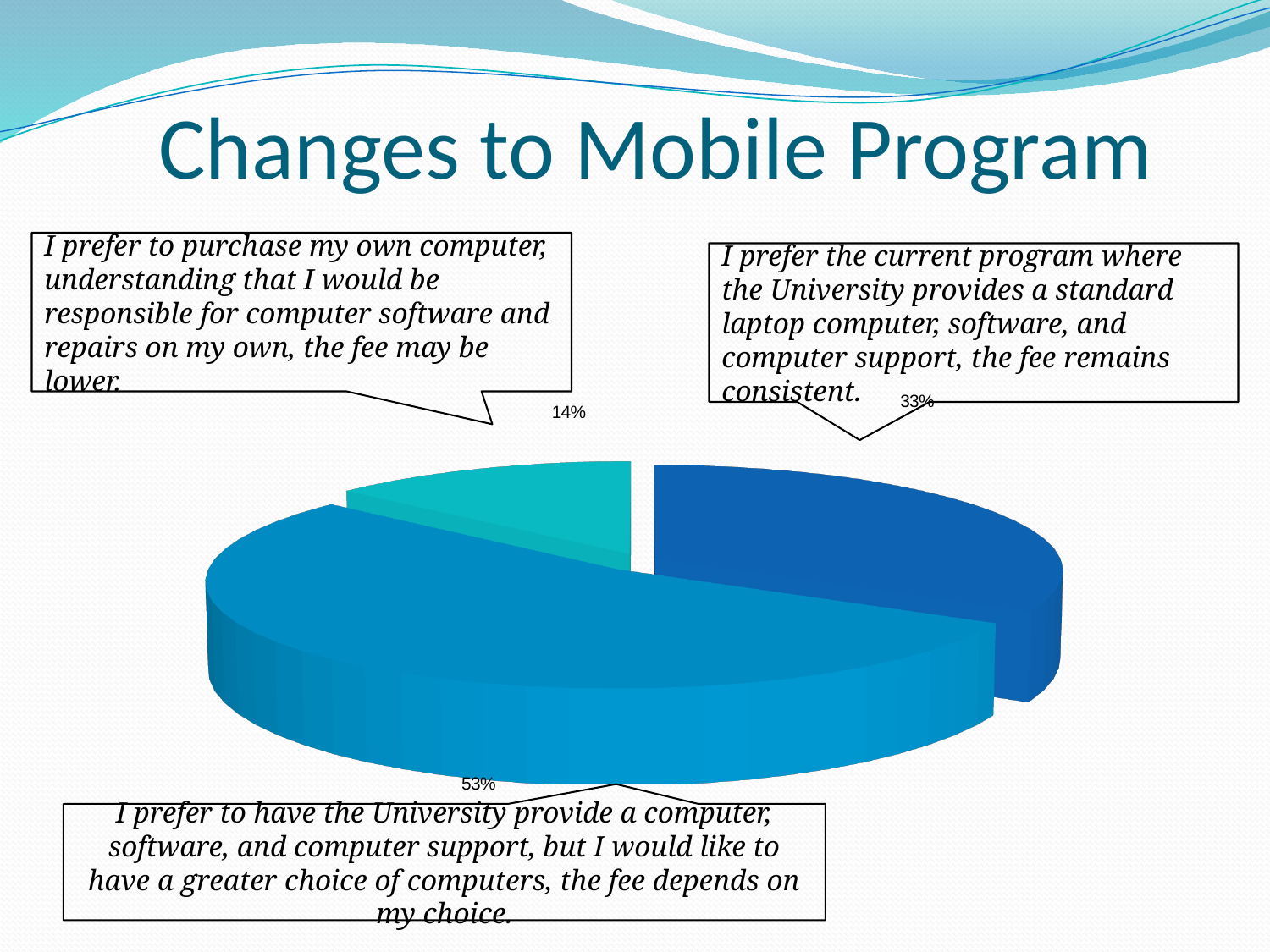
What colour is the slice representing 14%? teal What is the difference in percentage points between the 'greater choice of computers' option and the 'current program' option? 20 Which option has the largest share of the pie? I prefer to have the University provide a computer, software, and computer support, but I would like to have a greater choice of computers What percentage of respondents prefer to purchase their own computer? 14% What is the difference in percentage points between the 'current program' option and the 'purchase my own computer' option? 19 How many slices does the pie chart have? 3 What is the title of the slide containing the pie chart? Changes to Mobile Program What percentage of respondents prefer the current program where the University provides a standard laptop? 33% Which option has the smallest share of the pie? I prefer to purchase my own computer What percentage of respondents prefer the University provide a computer but with a greater choice of computers? 53% Which is larger: the share for the current program or the share for purchasing one's own computer? the current program What kind of chart is shown on the slide? pie chart